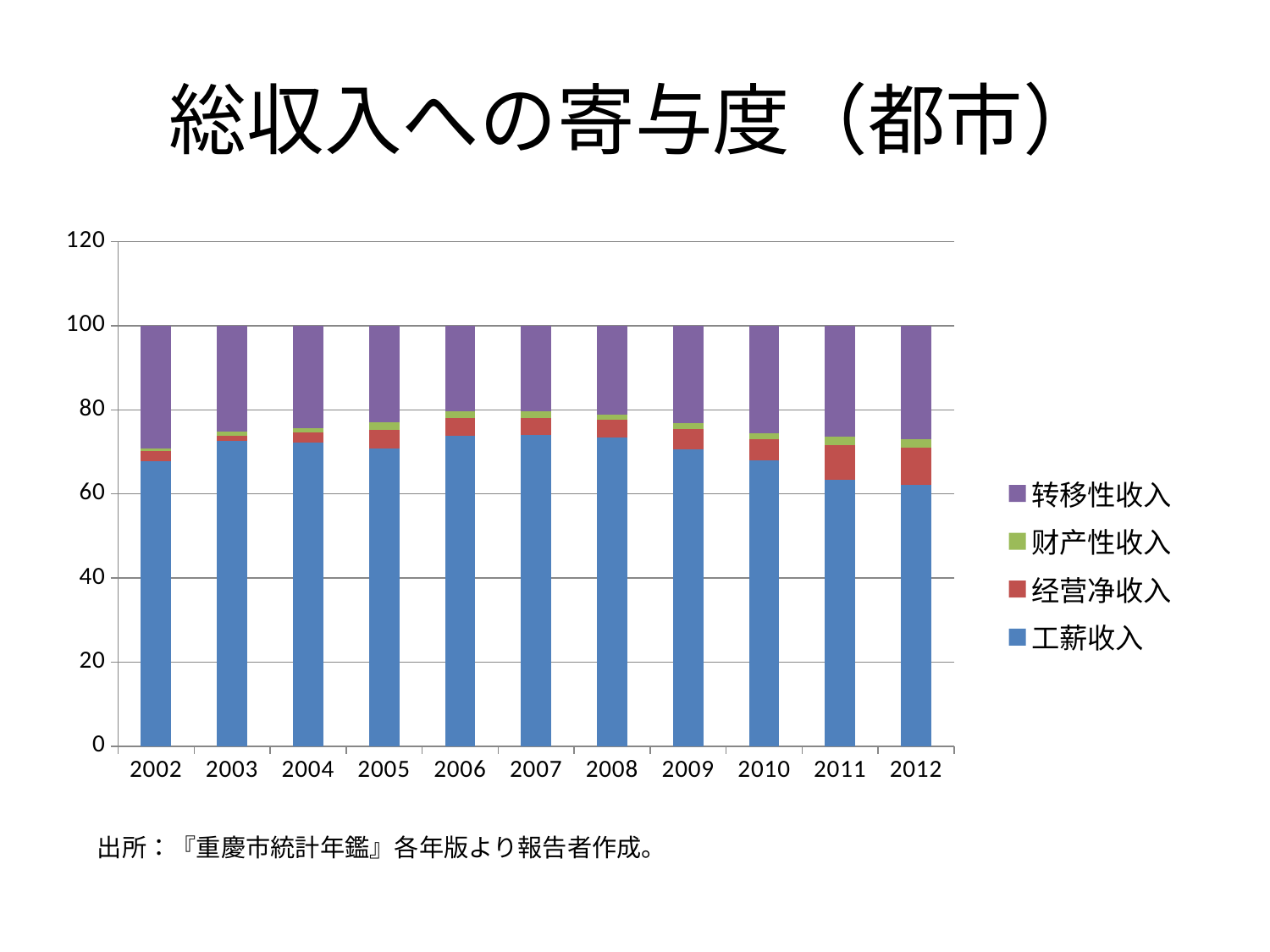
Which year has the larger 转移性收入 segment, 2007 or 2012? 2012 Is the value for 工薪收入 in 2012 greater or less than 80? less How many years are shown on the x axis of the chart? 11 What is the total height of the stacked bar for 2005? 100 What is the title of the chart on the slide? 総収入への寄与度（都市） Which series is shown in blue in the chart? 工薪收入 Does the 工薪收入 segment rise or fall from 2007 to 2012? fall What kind of chart is shown on the slide? Stacked bar chart Which year has the larger 工薪收入 segment, 2007 or 2012? 2007 Is the value for 工薪收入 in 2002 greater or less than 60? greater How many series does the legend list? 4 Is the value for 工薪收入 in 2007 greater or less than 60? greater